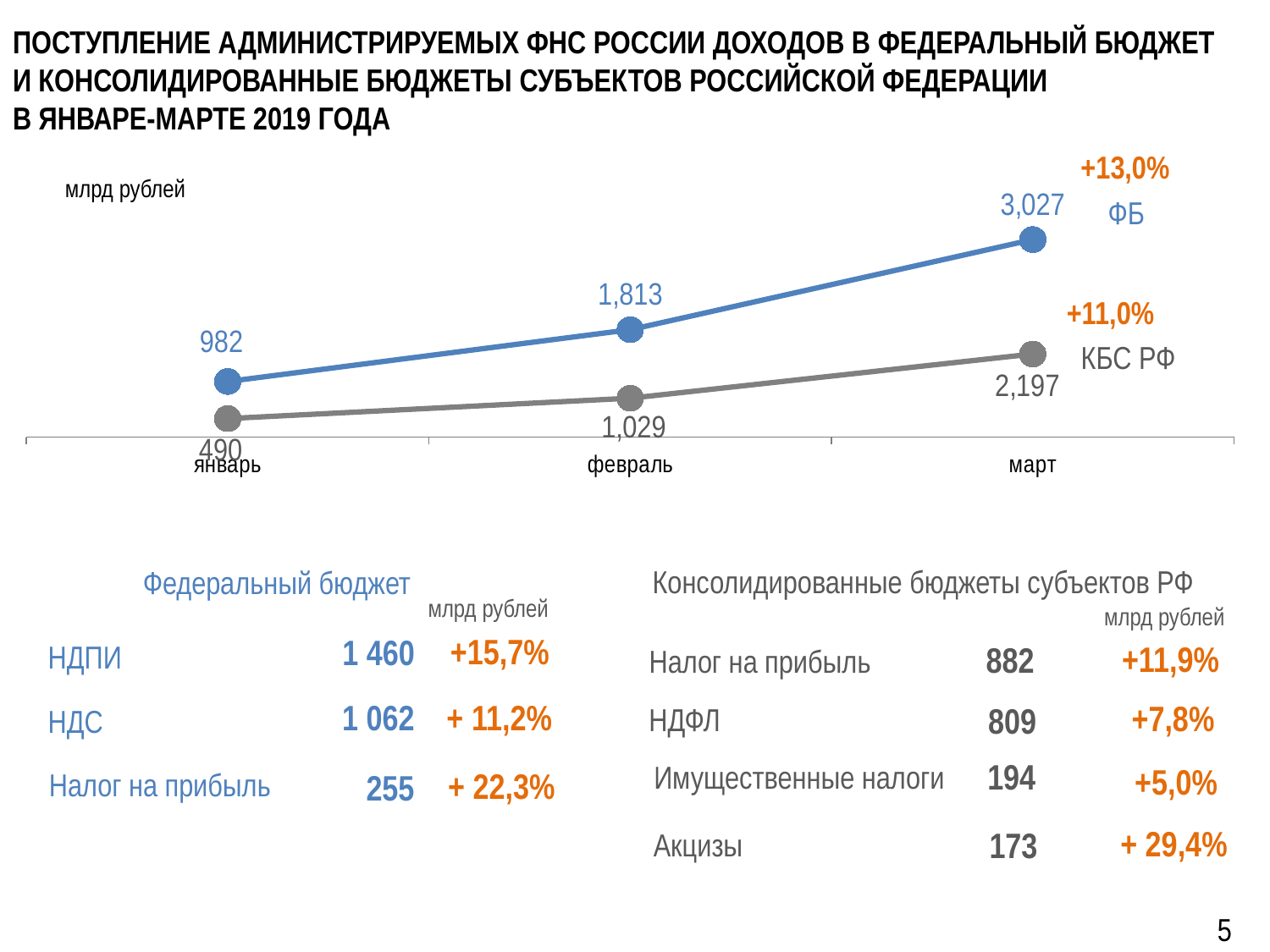
What is the value for ФБ in январь? 982 What is the value for ФБ in март? 3,027 What is the difference between ФБ and КБС РФ in март? 830 What kind of chart is shown? line chart In which month is the ФБ series highest? март What is the difference between the ФБ values in февраль and январь? 831 What is the value for КБС РФ in январь? 490 Does the КБС РФ series rise or fall from январь to март? rise Which is larger in февраль, ФБ or КБС РФ? ФБ In which month is the КБС РФ series lowest? январь How many months are plotted on the x axis? 3 What is the value for КБС РФ in февраль? 1,029